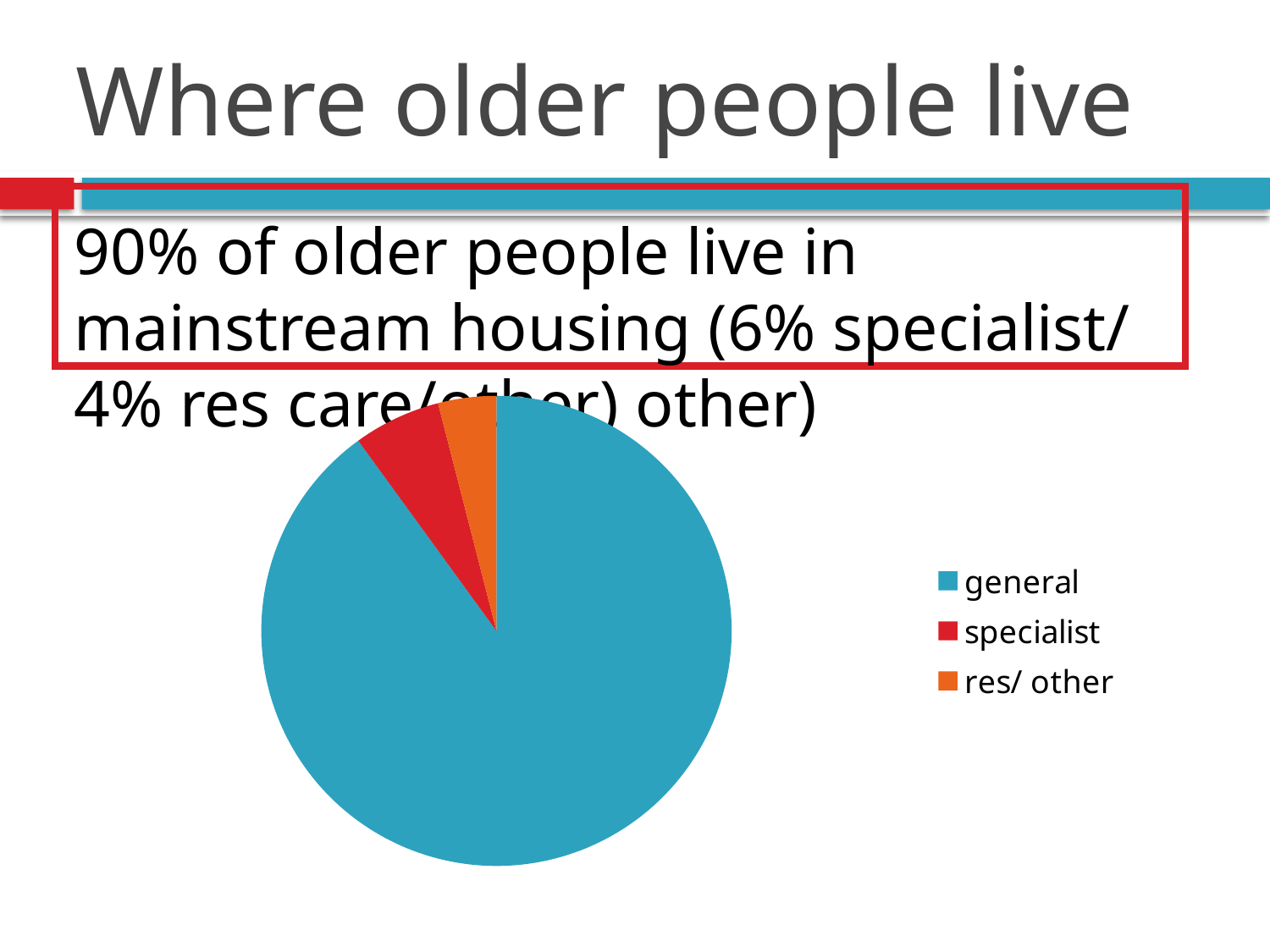
Which category has the smallest slice of the pie chart? res/ other Which category has the largest slice of the pie chart? general According to the slide text, what share of older people live in mainstream (general) housing? 90% What colour is the 'specialist' slice in the pie chart? red Which slice is larger in the pie chart, specialist or res/ other? specialist What is the title of the slide containing the pie chart? Where older people live According to the slide text, what share of older people live in specialist housing? 6% Which slice is larger in the pie chart, general or specialist? general How many entries does the legend of the pie chart list? 3 How many slices does the pie chart have? 3 According to the slide text, what share of older people live in res care/other? 4% What kind of chart is shown on the slide? pie chart